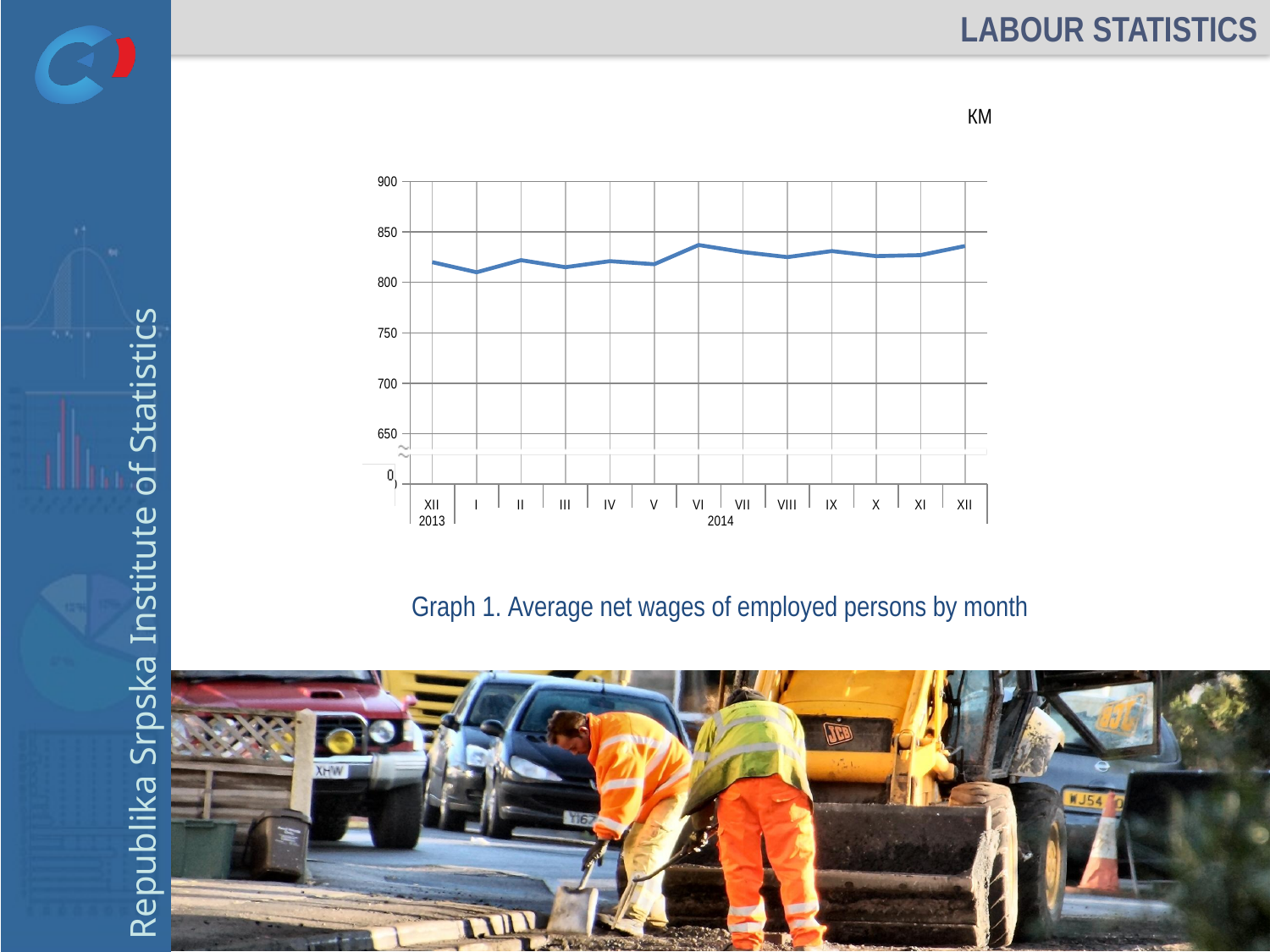
Do the values rise or fall from V 2014 to VI 2014? rise Which is larger, the value for XII 2014 or the value for III 2014? XII 2014 Is the value for VI 2014 greater or less than 800? greater How many monthly data points are plotted on the chart? 13 What is the title of the graph on the slide? Graph 1. Average net wages of employed persons by month Is the value for XII 2014 greater or less than 800? greater What unit is indicated for the values in the chart? KM Is the value for XII 2013 greater or less than 850? less Which is larger, the value for VI 2014 or the value for I 2014? VI 2014 Which month has the lowest average net wage on the chart? I 2014 What kind of chart is shown on the slide? line chart